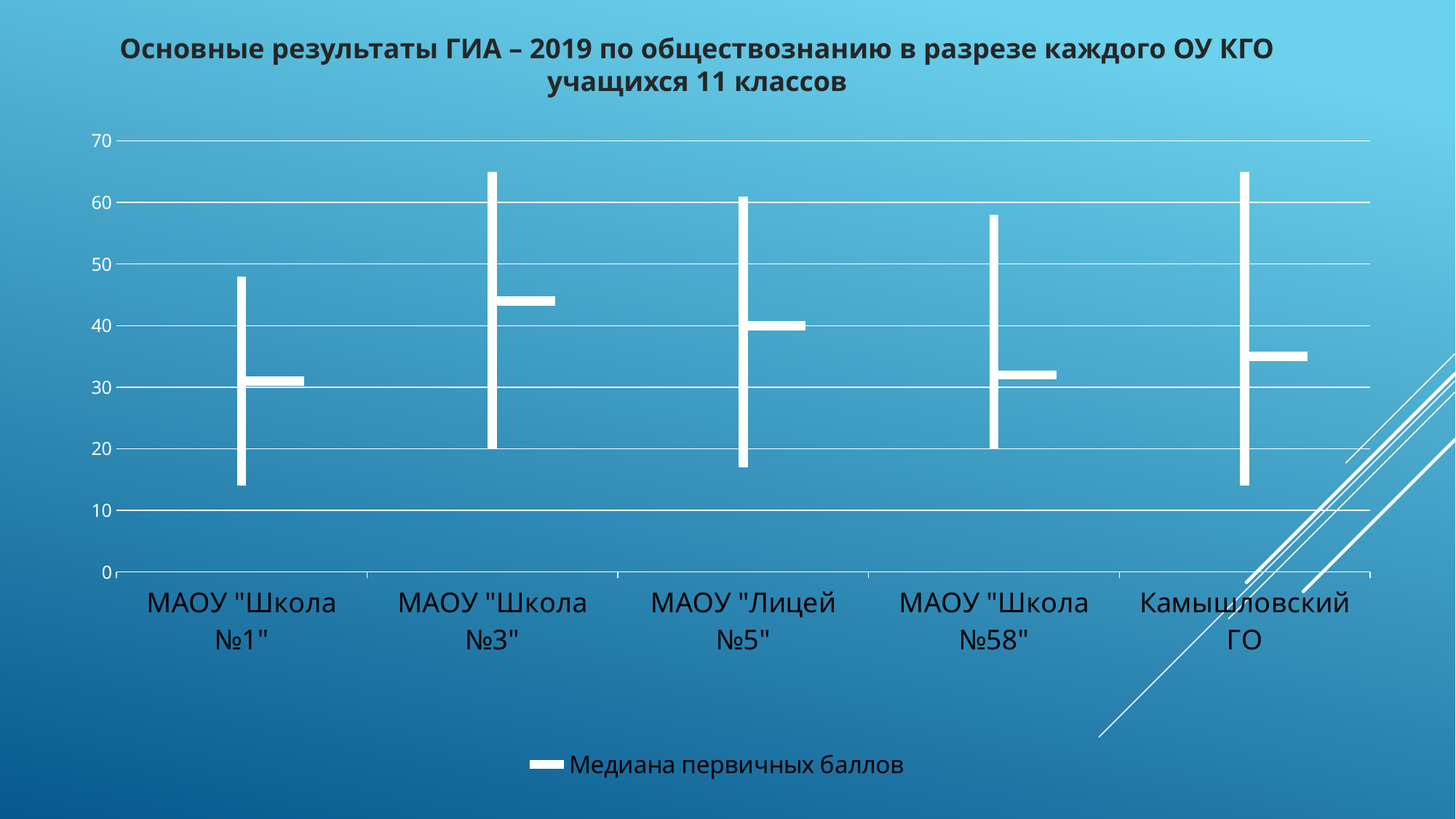
What is the title of the chart? Основные результаты ГИА – 2019 по обществознанию в разрезе каждого ОУ КГО учащихся 11 классов Which school has the highest median of primary scores? МАОУ "Школа №3" How many schools (categories) are shown on the x axis of the chart? 5 How many series does the chart legend list? 1 Is the median of primary scores for МАОУ "Лицей №5" greater or less than 30? greater Which has the larger median of primary scores, МАОУ "Лицей №5" or МАОУ "Школа №58"? МАОУ "Лицей №5" Which has the larger median of primary scores, МАОУ "Школа №3" or МАОУ "Школа №1"? МАОУ "Школа №3" Is the median of primary scores for МАОУ "Школа №3" greater or less than 40? greater Is the median of primary scores for МАОУ "Школа №58" greater or less than 40? less What is the name of the series shown in the chart legend? Медиана первичных баллов